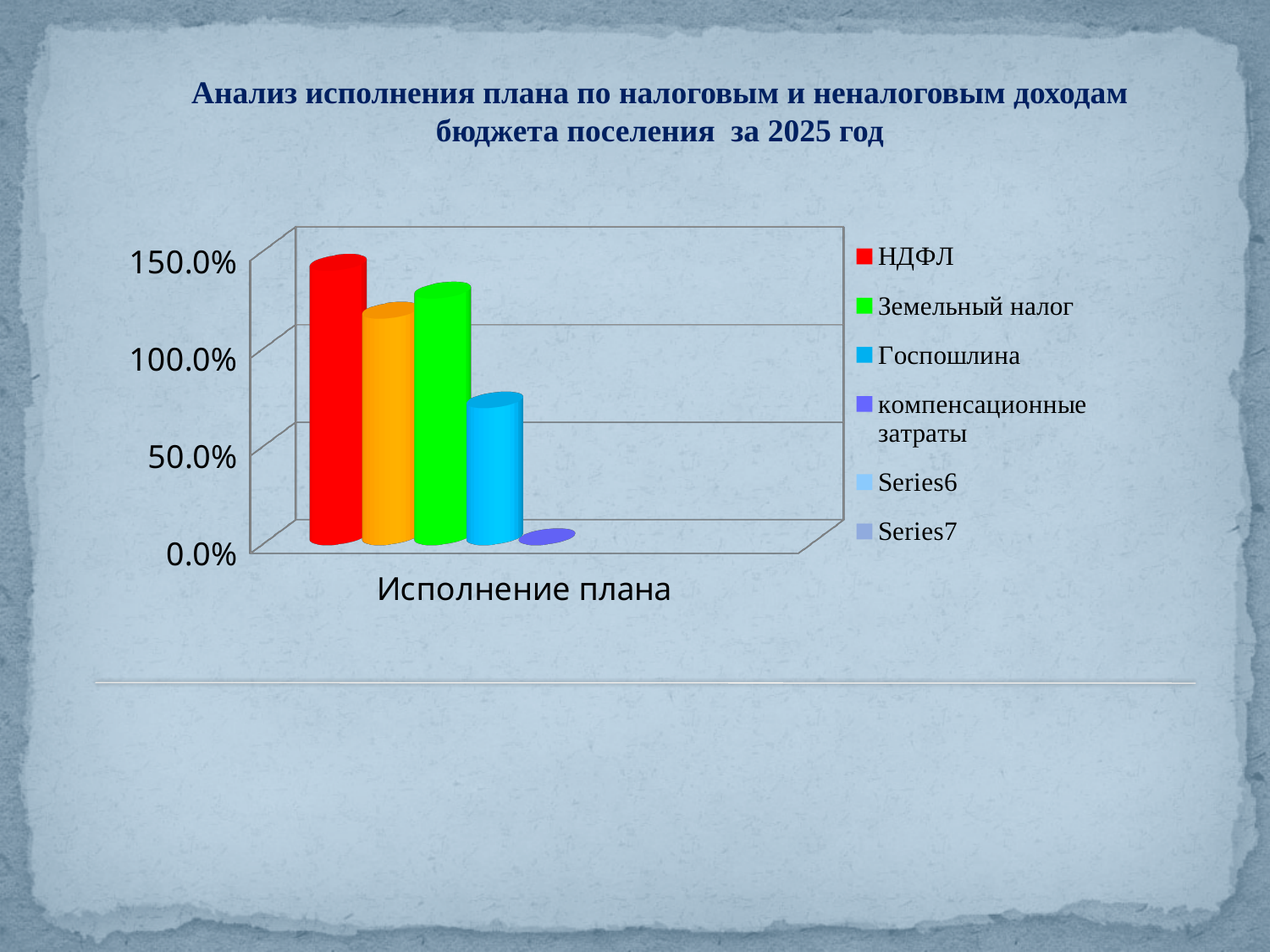
What is the highest tick value shown on the vertical axis of the chart? 150.0% Is the value for Земельный налог greater or less than 100.0%? greater How many categories are shown on the horizontal axis of the chart? 1 What is the category label shown on the horizontal axis of the chart? Исполнение плана Which is larger, the value for Земельный налог or the value for Госпошлина? Земельный налог Is the value for Госпошлина greater or less than 50.0%? greater What kind of chart is shown on the slide? bar chart Is the value for НДФЛ greater or less than 100.0%? greater How many series does the chart legend list? 6 Which series has the tallest bar in the chart? НДФЛ Which is larger, the value for НДФЛ or the value for Госпошлина? НДФЛ